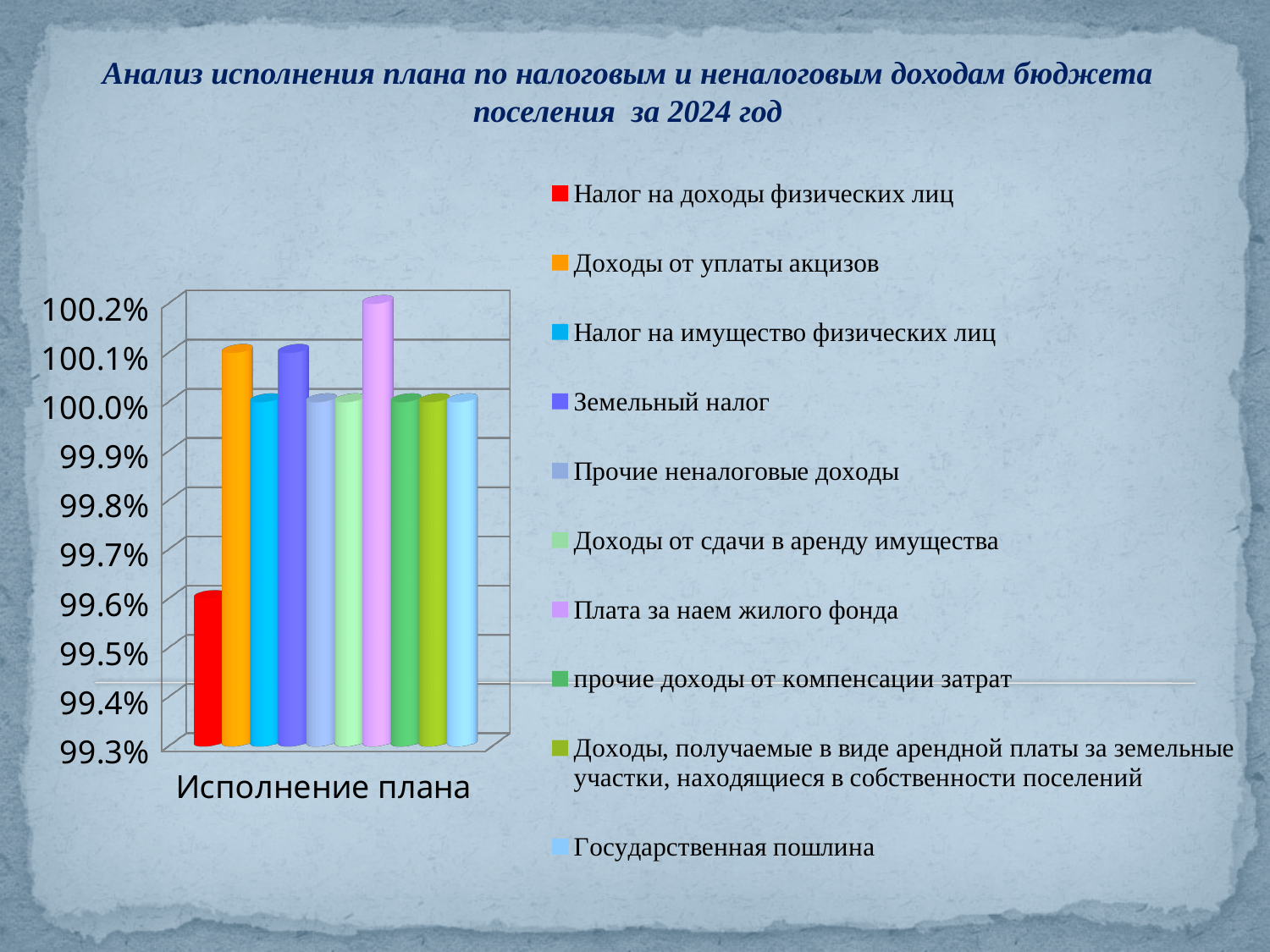
What kind of chart is shown on the slide? bar chart Is the value for Налог на доходы физических лиц greater or less than 99.8%? less How many categories are shown on the x axis? 1 Which series is shown in red in the legend? Налог на доходы физических лиц Which series has the lowest value? Налог на доходы физических лиц Is the value for Плата за наем жилого фонда greater or less than 100.1%? greater Is the value for Доходы от уплаты акцизов greater or less than 100.0%? greater Which is larger, the value for Плата за наем жилого фонда or the value for Земельный налог? Плата за наем жилого фонда What is the category label shown on the x axis? Исполнение плана Which is larger, the value for Налог на доходы физических лиц or the value for Доходы от уплаты акцизов? Доходы от уплаты акцизов Which series has the highest value? Плата за наем жилого фонда How many series does the legend list? 10